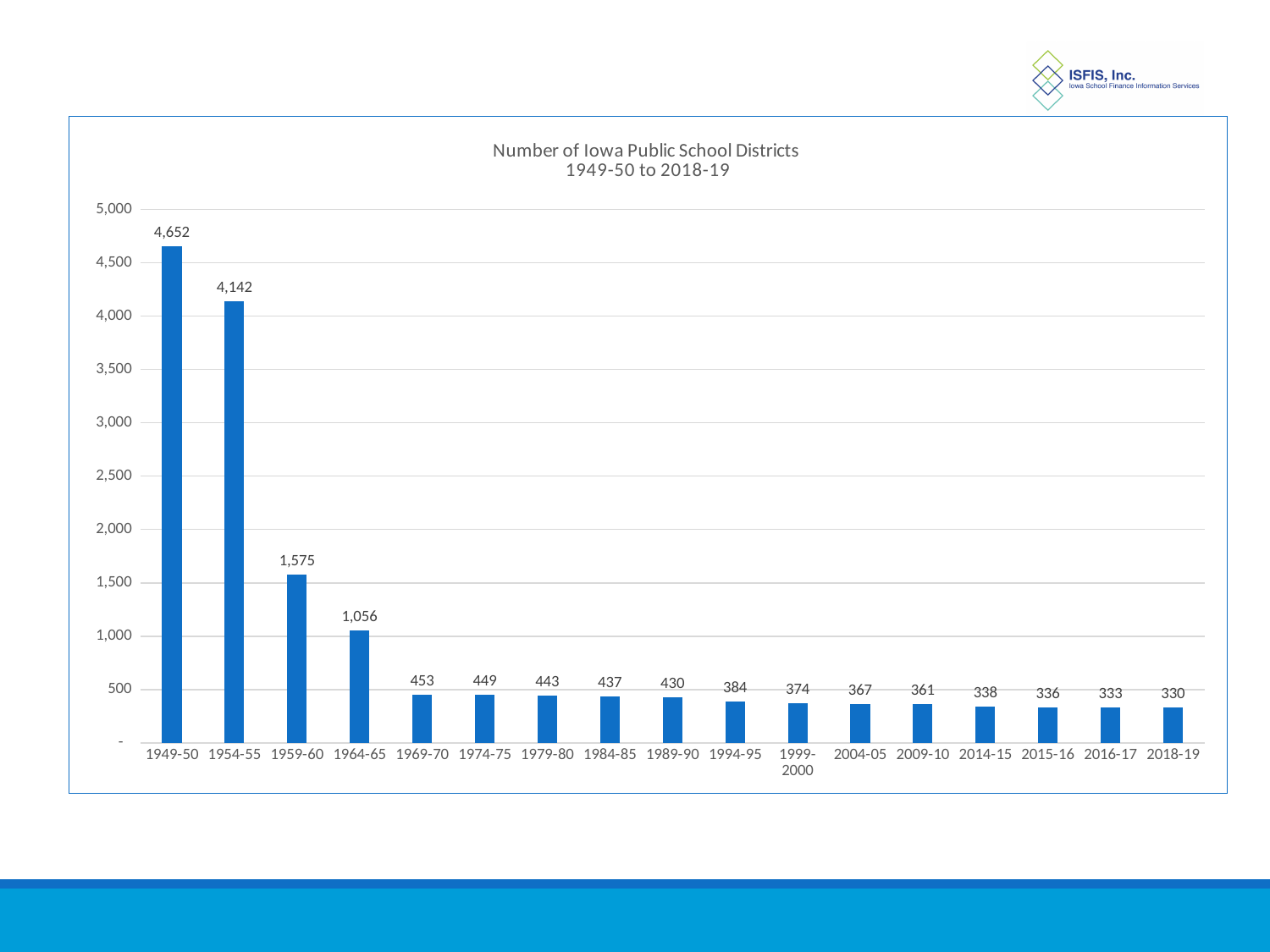
Do the values rise or fall from 1949-50 to 2018-19? Fall How many school years are shown on the x axis? 17 What is the number of Iowa public school districts in 1999-2000? 374 Which school year has the highest number of districts? 1949-50 What is the difference in the number of districts between 1959-60 and 1964-65? 519 What kind of chart is shown on the slide? Bar chart What is the number of Iowa public school districts in 2018-19? 330 Which school year has the lowest number of districts? 2018-19 What is the number of Iowa public school districts in 1964-65? 1,056 Which year has more districts, 1969-70 or 1994-95? 1969-70 What is the number of Iowa public school districts in 1949-50? 4,652 What is the difference in the number of districts between 1949-50 and 1954-55? 510